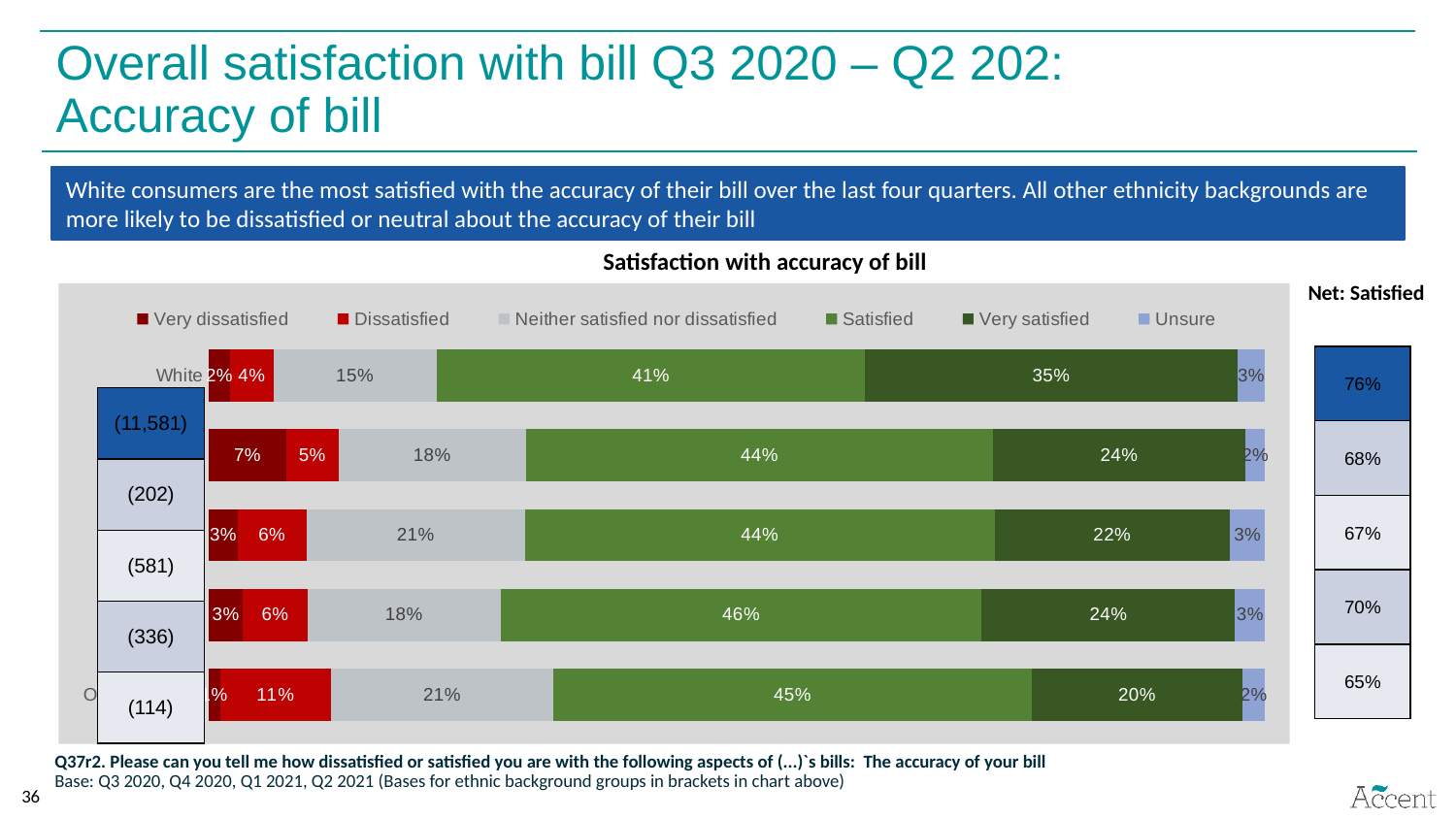
Which is larger for White consumers: the 'Dissatisfied' share or the 'Very dissatisfied' share? Dissatisfied What type of chart is used to show satisfaction with accuracy of bill? Stacked bar chart What is the lowest Net: Satisfied figure shown on the slide? 65% What is the 'Neither satisfied nor dissatisfied' value for White consumers? 15% What percentage of White consumers are 'Satisfied' with the accuracy of their bill? 41% What percentage of White consumers are 'Very satisfied' with the accuracy of their bill? 35% How many series does the legend of the satisfaction with accuracy of bill chart list? 6 What is the Net: Satisfied figure for White consumers? 76% How many bars (ethnic background groups) are shown in the satisfaction with accuracy of bill chart? 5 What is the title of the chart on the slide? Satisfaction with accuracy of bill Which group has the highest 'Very satisfied' percentage? White What is the difference between the 'Satisfied' and 'Very satisfied' percentages for White consumers? 6 percentage points